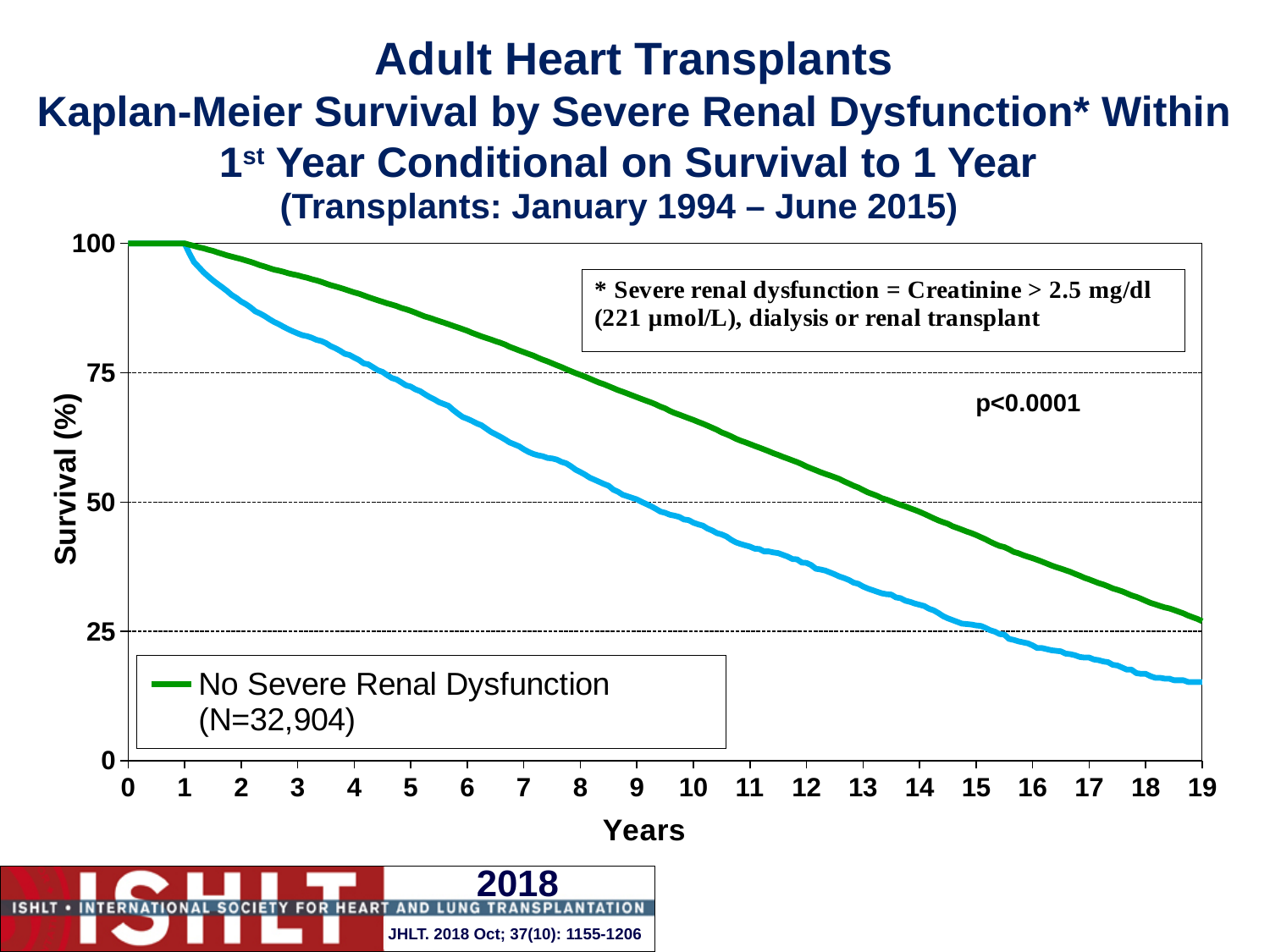
Is the survival value for the No Severe Renal Dysfunction line at year 10 greater or less than 50? greater How many series does the legend list? 1 What p-value is shown on the chart? p<0.0001 Is the survival value for the No Severe Renal Dysfunction line at year 5 greater or less than 75? greater Is the survival value for the blue line at year 10 greater or less than 50? less At year 10, which line shows higher survival, the green line or the blue line? the green line Do the survival curves rise or fall as the number of years increases? fall What kind of chart is shown on the slide? line chart What is the N for the No Severe Renal Dysfunction group shown in the legend? N=32,904 What is the survival value for the No Severe Renal Dysfunction line at year 0? 100